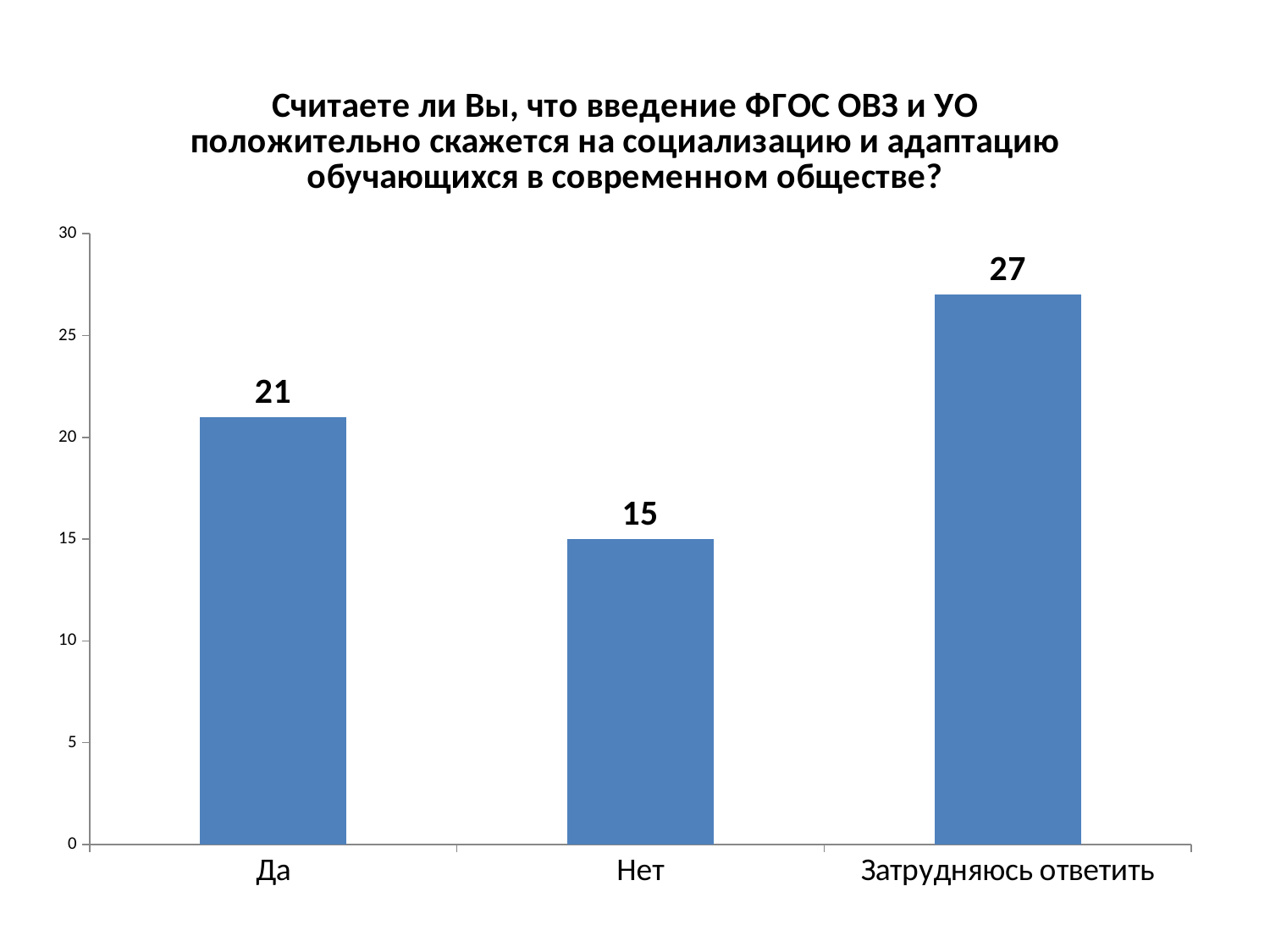
What is the maximum value shown on the vertical axis? 30 What is the difference between the values for "Затрудняюсь ответить" and "Да"? 6 Which category has the highest value? Затрудняюсь ответить What is the value for "Да"? 21 Which category has the lowest value? Нет What is the value for "Затрудняюсь ответить"? 27 What kind of chart is shown on the slide? bar chart How many categories are shown on the x axis? 3 What is the value for "Нет"? 15 Is the value for "Затрудняюсь ответить" greater or less than 25? greater Which is larger, the value for "Да" or the value for "Нет"? Да What is the difference between the values for "Да" and "Нет"? 6